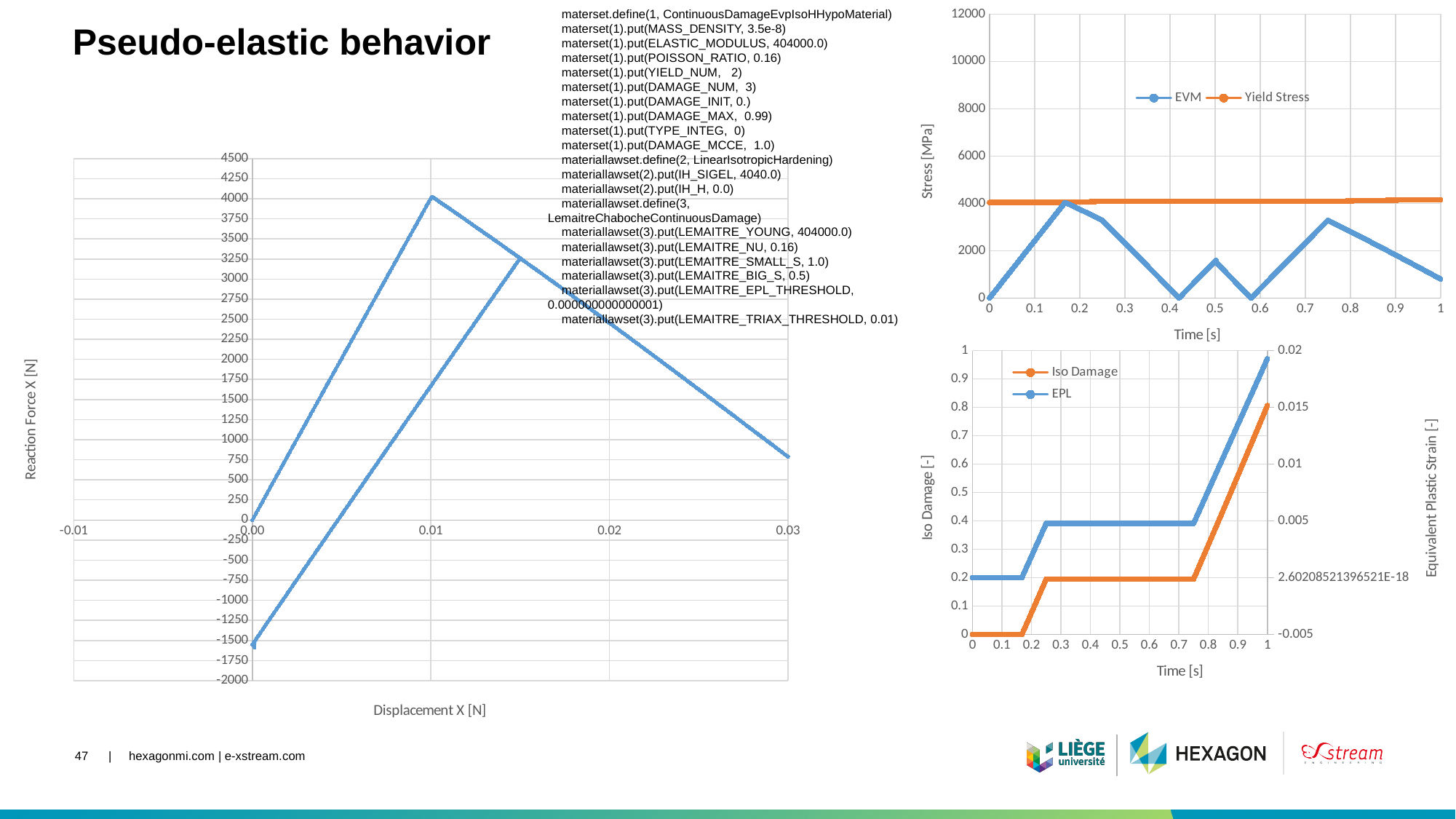
In the large chart on the left, what is the label of the vertical axis? Reaction Force X [N] In the large chart on the left, is the reaction force at displacement 0.03 greater or less than 1000? less In the top-right chart (Stress vs Time), at time 0.5, which series has the larger value, EVM or Yield Stress? Yield Stress In the bottom-right chart, does the Iso Damage series rise or fall between time 0.8 and time 1? rise How many series does the legend of the top-right chart (Stress vs Time) list? 2 In the top-right chart (Stress vs Time), which series is shown in orange? Yield Stress In the bottom-right chart, is the Iso Damage value at time 1 greater or less than 0.5? greater What kind of chart is the large chart on the left of the slide? line chart In the top-right chart (Stress vs Time), is the EVM value at time 0.4 greater or less than 1000? less How many series does the legend of the bottom-right chart (Iso Damage vs Time) list? 2